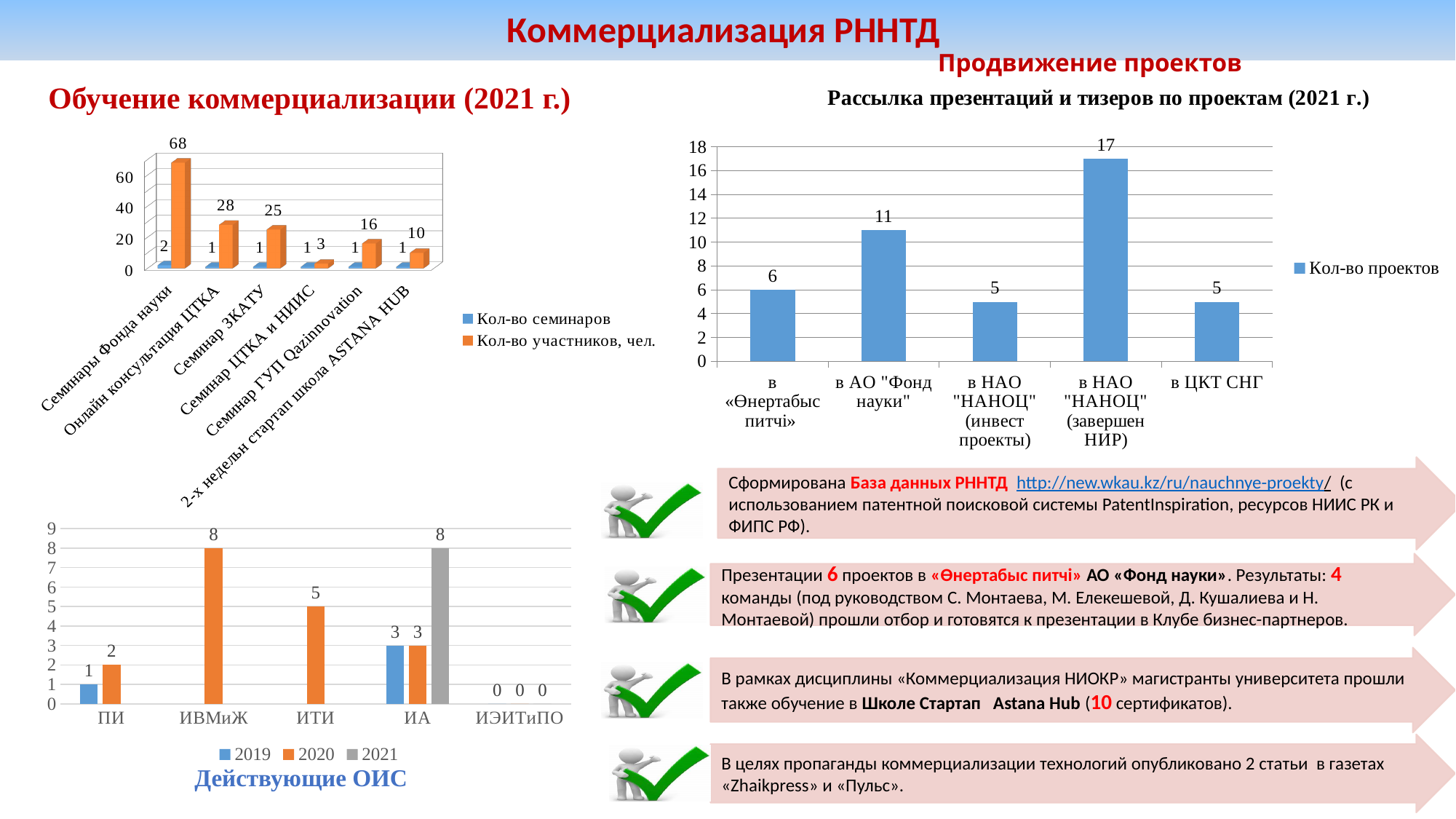
In the chart titled "Рассылка презентаций и тизеров по проектам (2021 г.)", which category has the highest value? в НАО "НАНОЦ" (завершен НИР) In the chart titled "Обучение коммерциализации (2021 г.)", how many series does the legend list? 2 In the chart titled "Обучение коммерциализации (2021 г.)", what is the value of Кол-во участников, чел. for Семинары Фонда науки? 68 In the chart titled "Обучение коммерциализации (2021 г.)", is Кол-во участников, чел. larger for Семинар ЗКАТУ or for Семинар ГУП Qazinnovation? Семинар ЗКАТУ What kind of chart is the chart titled "Действующие ОИС"? Bar chart In the chart titled "Рассылка презентаций и тизеров по проектам (2021 г.)", how many categories are shown? 5 In the chart titled "Действующие ОИС", how many series does the legend list? 3 In the chart titled "Обучение коммерциализации (2021 г.)", which category has the lowest value of Кол-во участников, чел.? Семинар ЦТКА и НИИС In the chart titled "Действующие ОИС", what is the value for ИТИ in 2020? 5 In the chart titled "Рассылка презентаций и тизеров по проектам (2021 г.)", what is the difference between the values for в АО "Фонд науки" and в «Өнертабыс питчі»? 5 In the chart titled "Рассылка презентаций и тизеров по проектам (2021 г.)", what is the value for в НАО "НАНОЦ" (завершен НИР)? 17 In the chart titled "Действующие ОИС", what is the value for ИА in 2021? 8